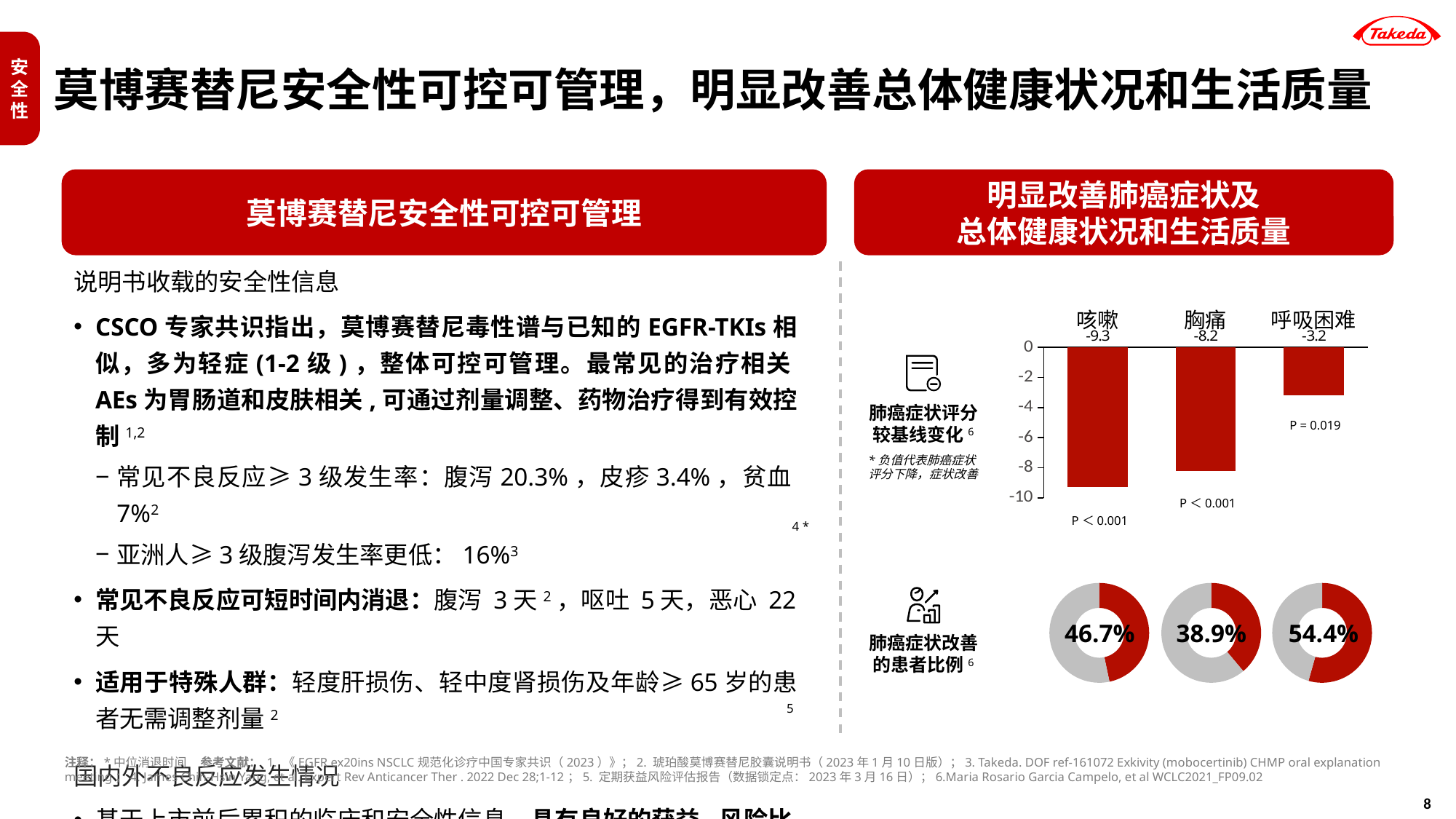
In the bar chart of lung cancer symptom score change from baseline, which category shows the largest decrease? 咳嗽 In the bar chart of lung cancer symptom score change from baseline, what P value is shown for 呼吸困难? P = 0.019 In the bar chart of lung cancer symptom score change from baseline, how many categories are shown? 3 In the bar chart of lung cancer symptom score change from baseline, what is the value for 呼吸困难? -3.2 In the bar chart of lung cancer symptom score change from baseline (肺癌症状评分较基线变化), what is the value for 咳嗽? -9.3 What kind of chart is used to show the lung cancer symptom score change from baseline? Bar chart In the bar chart of lung cancer symptom score change from baseline, which category shows the smallest decrease? 呼吸困难 In the donut charts showing the proportion of patients with lung cancer symptom improvement (肺癌症状改善的患者比例), what is the value of the leftmost donut? 46.7% In the bar chart of lung cancer symptom score change from baseline, what is the difference between the values for 咳嗽 and 呼吸困难? 6.1 In the donut charts showing the proportion of patients with lung cancer symptom improvement, what is the value of the middle donut? 38.9% In the bar chart of lung cancer symptom score change from baseline, what is the value for 胸痛? -8.2 In the donut charts showing the proportion of patients with lung cancer symptom improvement, which donut shows the highest percentage? The rightmost donut, 54.4%